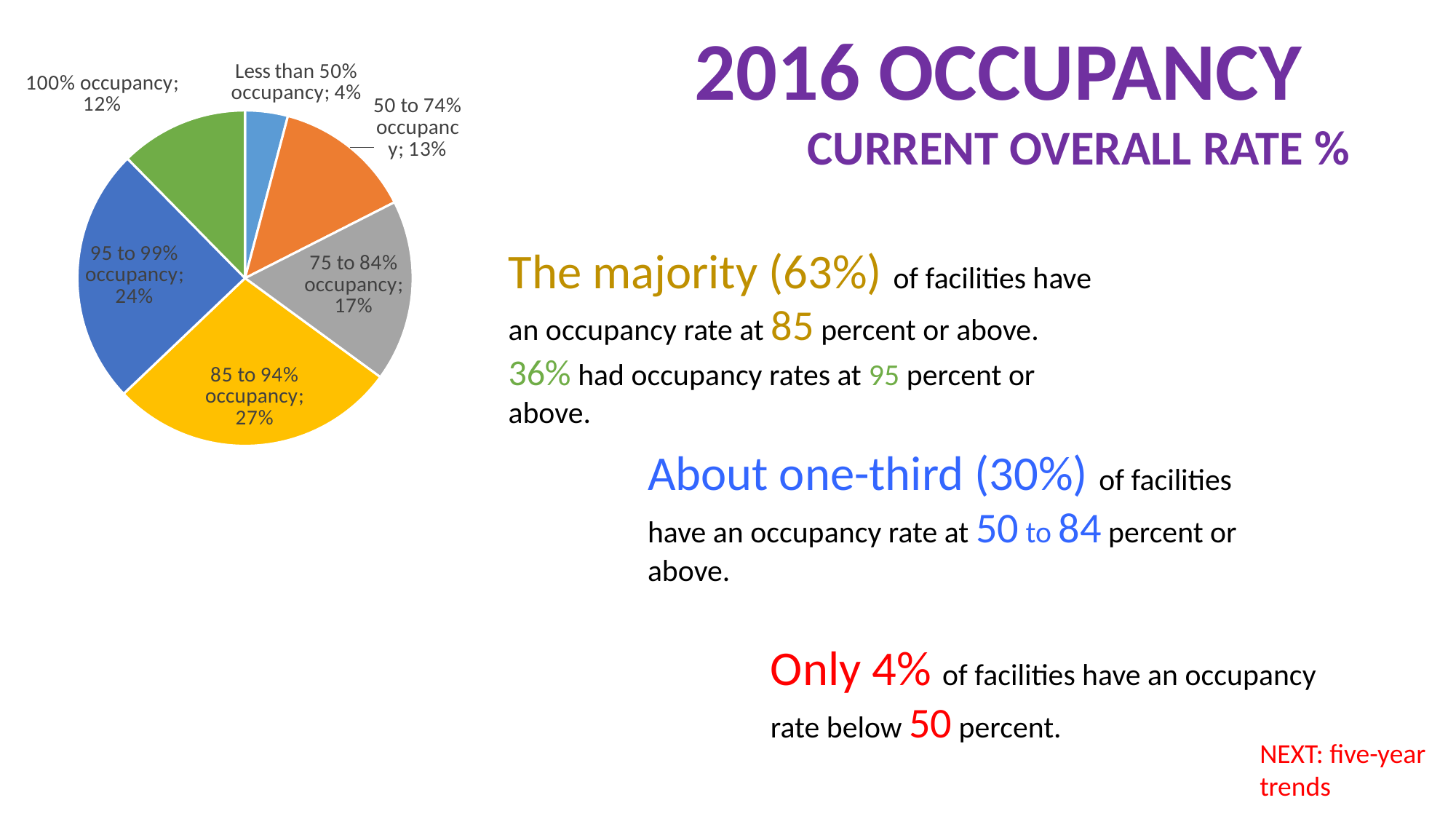
What is the combined share of the 95 to 99% occupancy and 100% occupancy slices? 36% What share of facilities have 75 to 84% occupancy? 17% What is the difference between the share for 95 to 99% occupancy and the share for 100% occupancy? 12% What share of facilities have 100% occupancy? 12% How many slices does the pie chart have? 6 What colour is the slice for 85 to 94% occupancy? yellow Which occupancy category has the smallest slice of the pie? Less than 50% occupancy What share of facilities have less than 50% occupancy? 4% What kind of chart is shown on the slide? pie chart Which occupancy category has the largest slice of the pie? 85 to 94% occupancy Which is larger, the share for 50 to 74% occupancy or the share for 75 to 84% occupancy? 75 to 84% occupancy What share of facilities have 85 to 94% occupancy? 27%